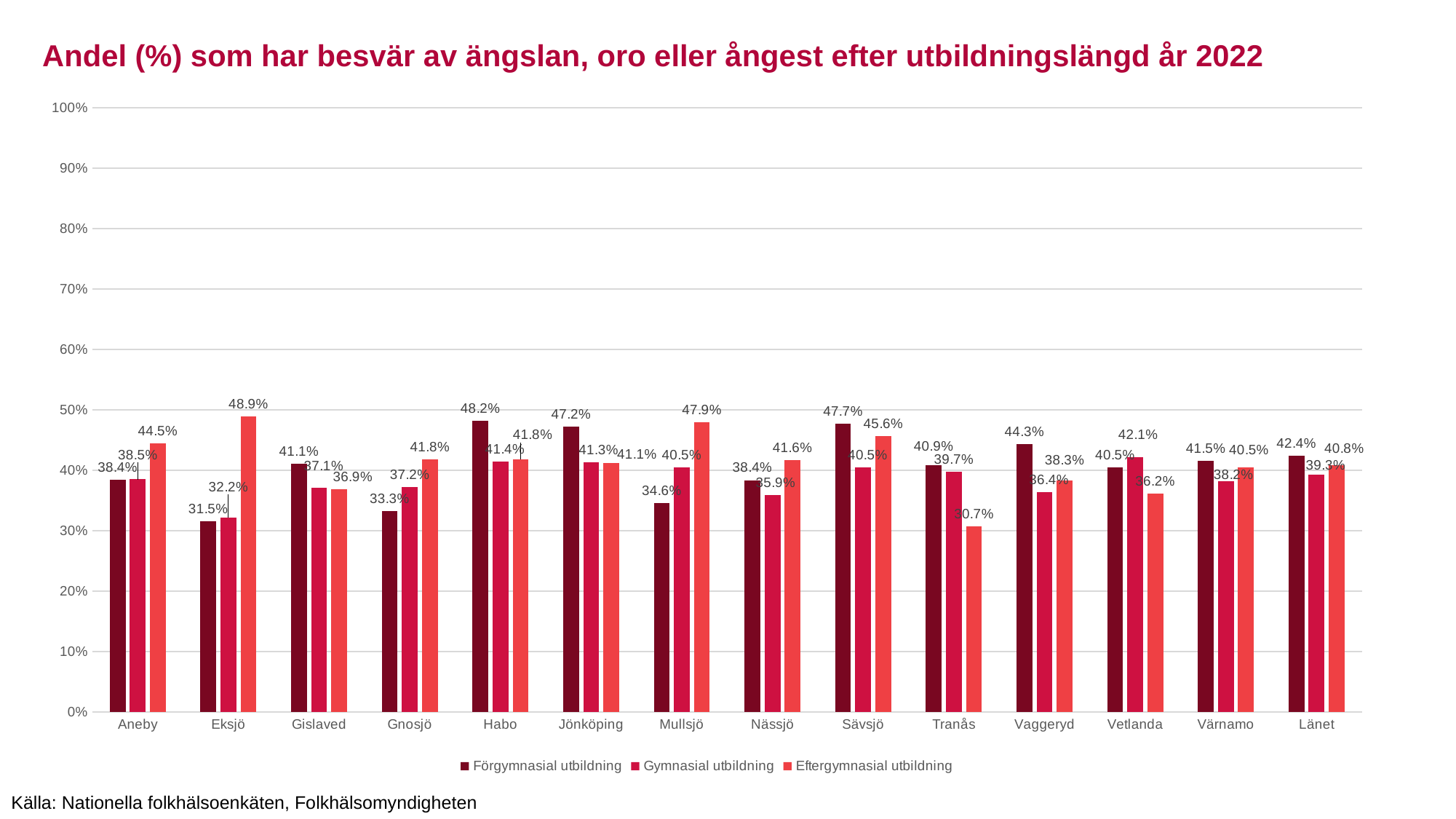
What is the value for Eftergymnasial utbildning in Eksjö? 48.9% Which category has the lowest value for Förgymnasial utbildning? Eksjö What is the difference between Eftergymnasial utbildning and Förgymnasial utbildning in Eksjö? 17.4 percentage points Is the value for Eftergymnasial utbildning in Mullsjö greater or less than 40%? greater What is the value for Förgymnasial utbildning in Habo? 48.2% Which category has the highest value for Eftergymnasial utbildning? Eksjö What is the value for Gymnasial utbildning in Länet? 39.3% Which is larger in Tranås: Förgymnasial utbildning or Eftergymnasial utbildning? Förgymnasial utbildning What kind of chart is shown on the slide? Bar chart How many series does the legend list? 3 Which category has the lowest value for Eftergymnasial utbildning? Tranås How many categories are shown on the x axis? 14